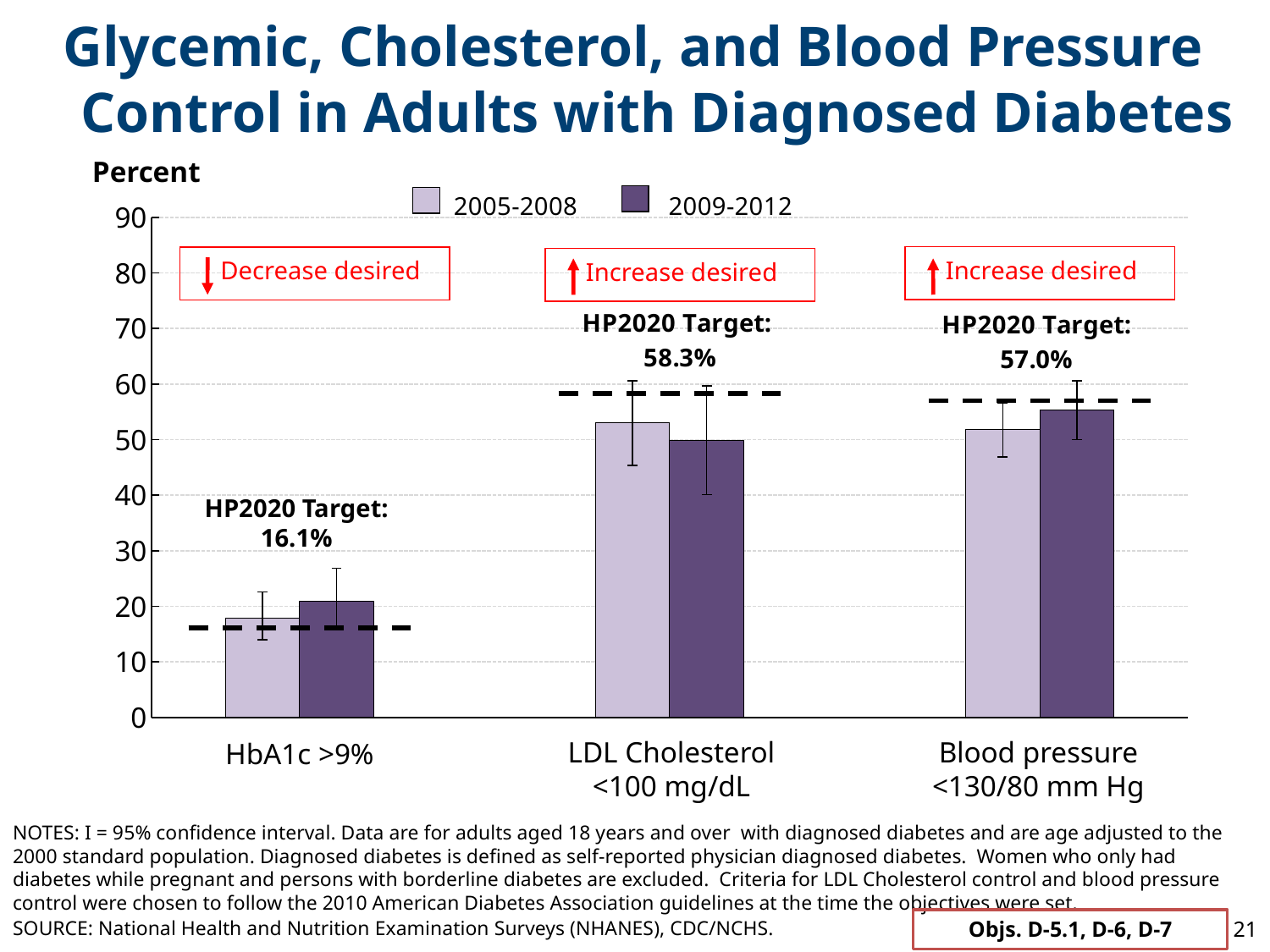
What is the HP2020 Target shown for HbA1c >9%? 16.1% What is the HP2020 Target shown for Blood pressure <130/80 mm Hg? 57.0% Which category has the lowest values for both periods? HbA1c >9% How many series does the legend list? 2 What kind of chart is shown on the slide? bar chart Is the 2005-2008 value for LDL Cholesterol <100 mg/dL greater or less than 50? greater How many categories are shown on the x axis? 3 What is the HP2020 Target shown for LDL Cholesterol <100 mg/dL? 58.3% What are the two periods listed in the legend? 2005-2008 and 2009-2012 For LDL Cholesterol <100 mg/dL, which period has the larger value, 2005-2008 or 2009-2012? 2005-2008 Is the 2005-2008 value for HbA1c >9% greater or less than 20? less Is the 2009-2012 value for Blood pressure <130/80 mm Hg greater or less than 50? greater